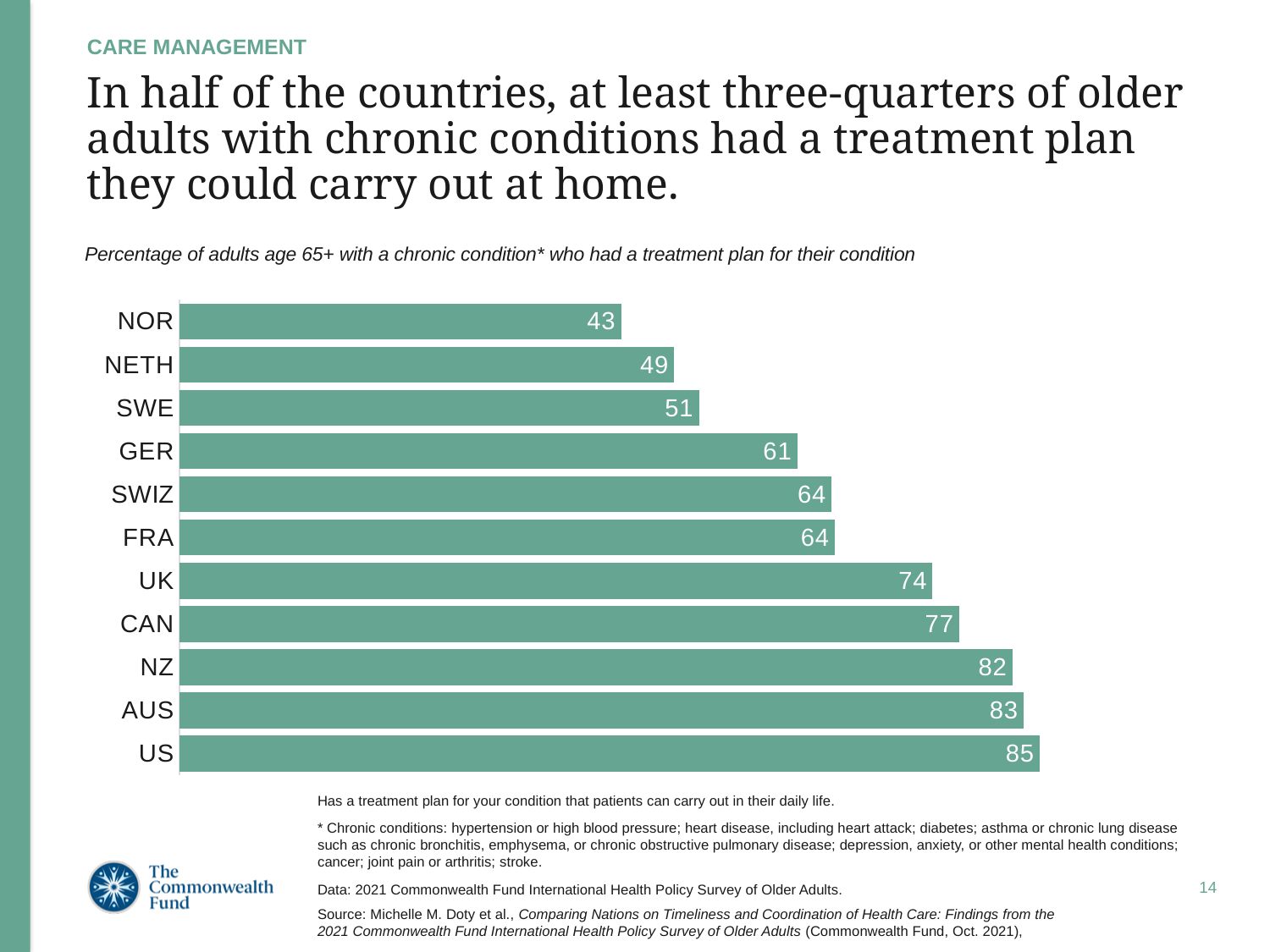
Which country has the lowest value? NOR How many countries are shown in the chart? 11 Which is larger, the value for SWE or the value for AUS? AUS Which country has the highest value? US What is the value for NETH? 49 What is the value for GER? 61 Which two countries share the same value of 64? SWIZ and FRA What kind of chart is shown on the slide? bar chart What is the difference between the values for CAN and UK? 3 What is the difference between the values for the US and NOR? 42 What is the subtitle describing what the chart measures? Percentage of adults age 65+ with a chronic condition* who had a treatment plan for their condition What is the value for the US? 85